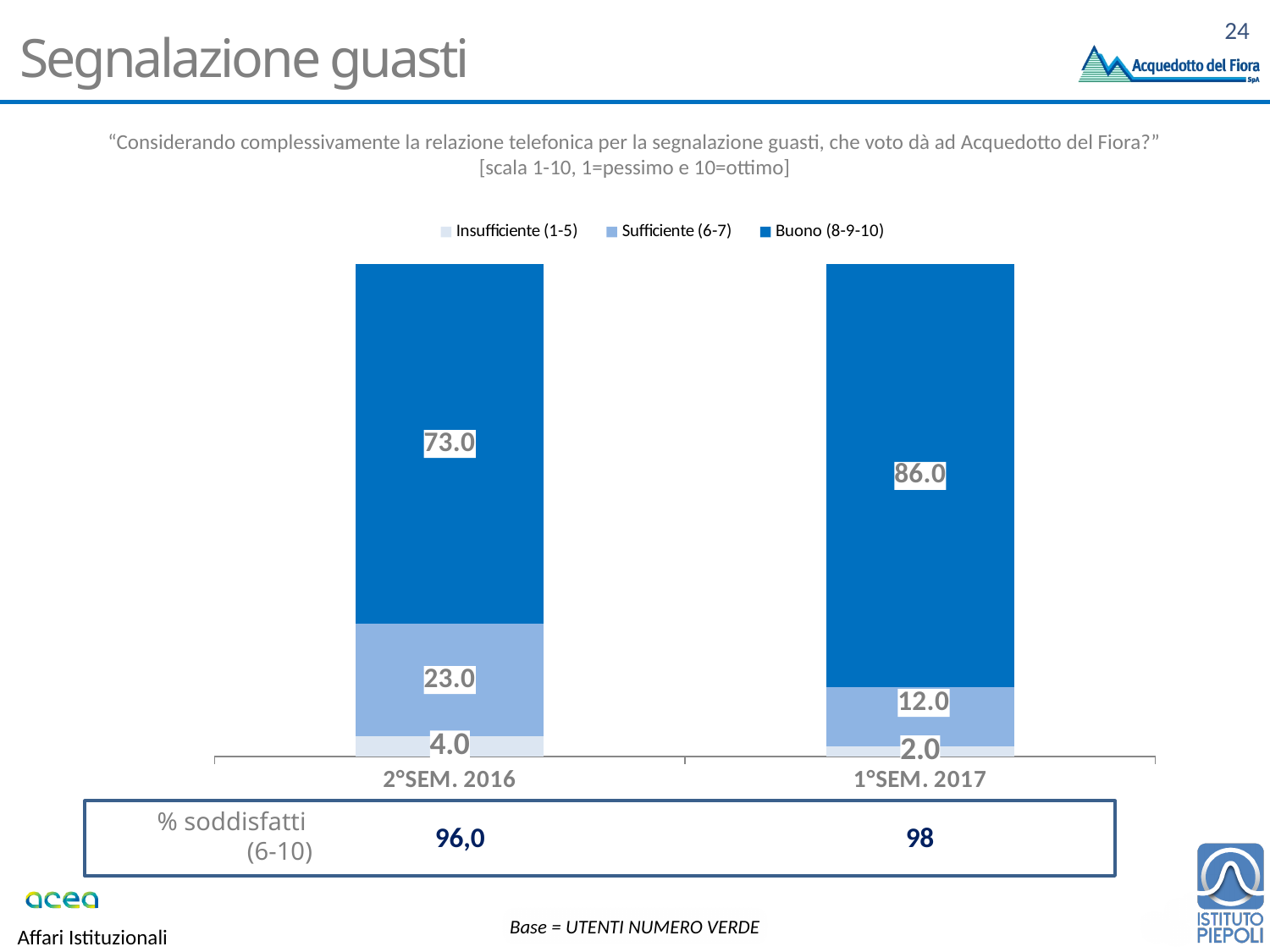
What is the total of the stacked bar for 2°SEM. 2016? 100.0 What is the value of Buono (8-9-10) for 2°SEM. 2016? 73.0 Which period has the higher value for Buono (8-9-10)? 1°SEM. 2017 What is the difference between the Buono (8-9-10) values for 1°SEM. 2017 and 2°SEM. 2016? 13.0 Does the Insufficiente (1-5) value rise or fall from 2°SEM. 2016 to 1°SEM. 2017? Fall What kind of chart is shown on the slide? Stacked bar chart What is the value of Insufficiente (1-5) for 1°SEM. 2017? 2.0 How many series does the legend list? 3 What is the value of Sufficiente (6-7) for 2°SEM. 2016? 23.0 What is the difference between the Sufficiente (6-7) values for 2°SEM. 2016 and 1°SEM. 2017? 11.0 What is the value of Buono (8-9-10) for 1°SEM. 2017? 86.0 How many categories are shown on the x axis? 2